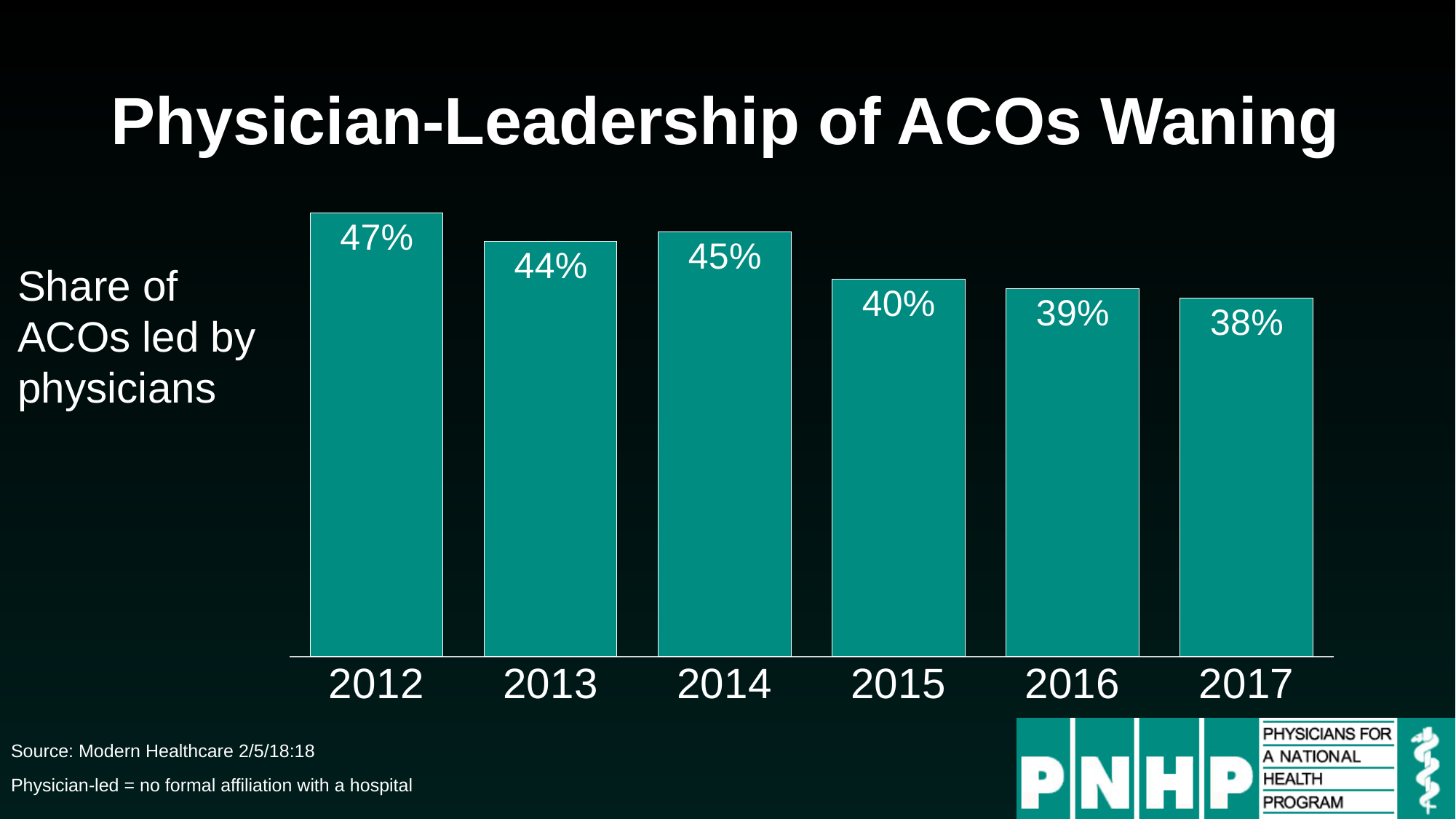
How many years are shown on the chart? 6 Overall, does the share of ACOs led by physicians rise or fall from 2012 to 2017? Fall What is the difference between the 2014 and 2013 values? 1 percentage point Which year has the lowest share of ACOs led by physicians? 2017 What kind of chart is shown on the slide? Bar chart What is the title of the slide? Physician-Leadership of ACOs Waning What share of ACOs were led by physicians in 2012? 47% What is the value shown for 2015? 40% Which year has the highest share of ACOs led by physicians? 2012 What share of ACOs were led by physicians in 2017? 38% Which year has a larger share of physician-led ACOs, 2013 or 2014? 2014 By how many percentage points did the share of physician-led ACOs fall from 2012 to 2017? 9 percentage points